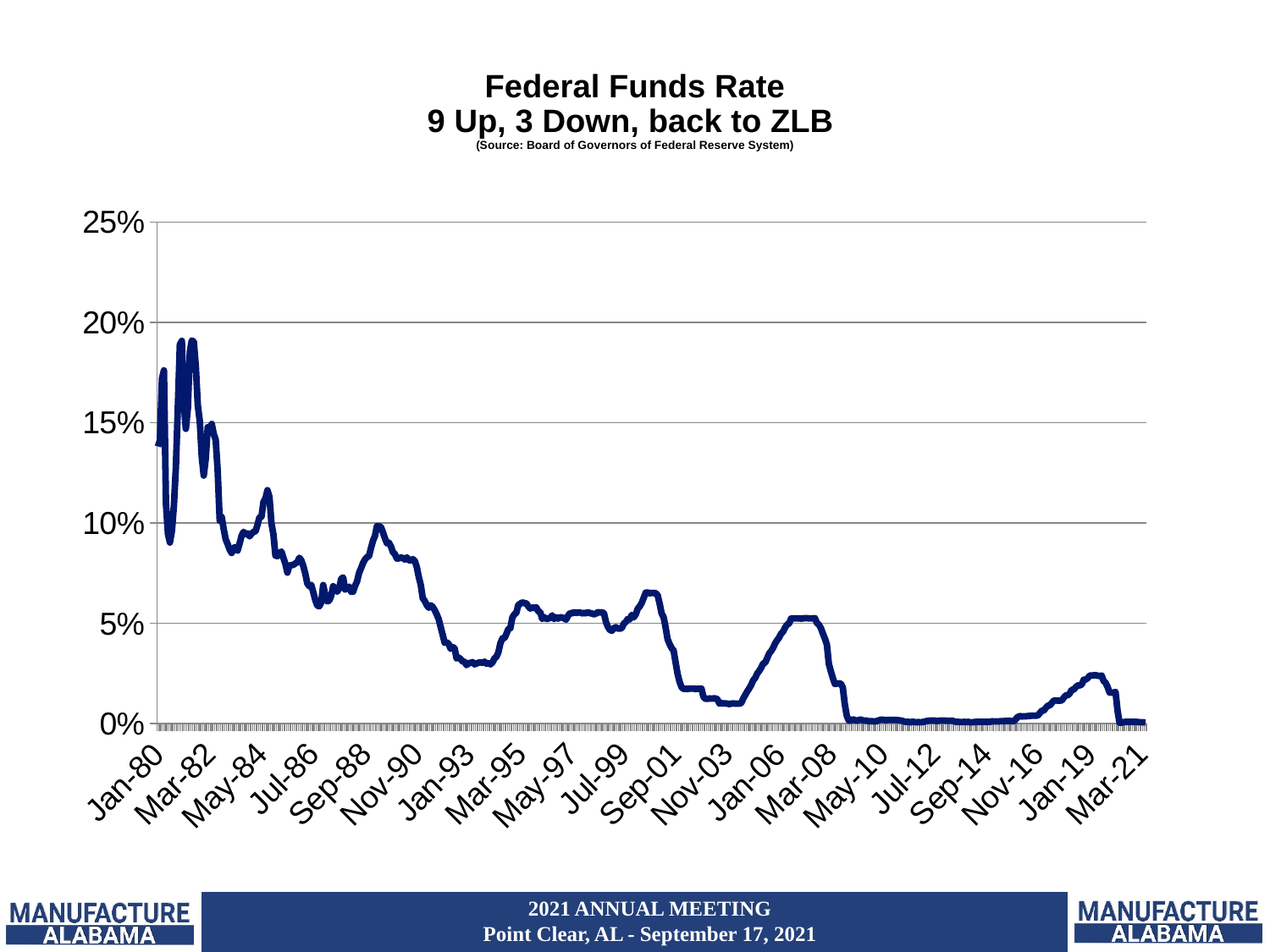
How many date labels are shown on the x axis? 20 Is the peak Federal Funds Rate shown on the chart greater or less than 15%? greater Is the Federal Funds Rate around Mar-82 greater or less than 10%? greater Is the Federal Funds Rate around Mar-21 greater or less than 5%? less What kind of chart is shown on the slide? line chart What is the highest value labelled on the y axis? 25% What is the title of the chart? Federal Funds Rate 9 Up, 3 Down, back to ZLB Overall, does the Federal Funds Rate rise or fall from Jan-80 to Mar-21? fall What source is cited for the chart data? Board of Governors of Federal Reserve System